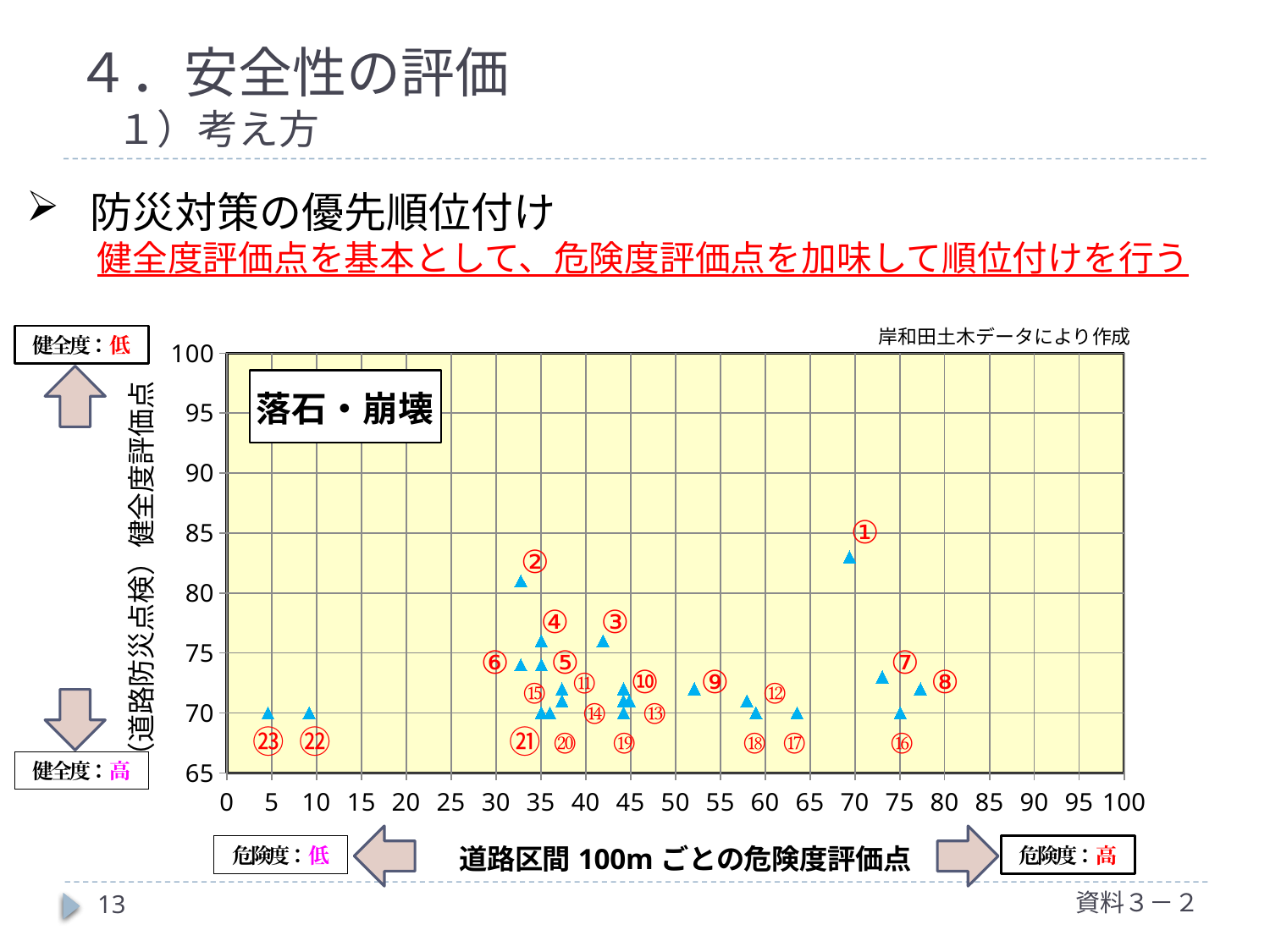
What kind of chart is shown on the slide? scatter chart Which numbered point has the lowest 危険度評価点 (x-axis value)? ㉓ Which numbered point has the highest 健全度評価点 (y-axis value)? ① Is the 危険度評価点 (x value) for point ㉓ greater or less than 10? less Is the 危険度評価点 (x value) for point ① greater or less than 65? greater How many numbered points are plotted on the chart? 23 Which has the larger 健全度評価点 (y value), point ① or point ②? point ① What is the label of the x axis of the chart? 道路区間 100m ごとの危険度評価点 Which has the larger 危険度評価点 (x value), point ③ or point ⑥? point ③ Is the 健全度評価点 (y value) for point ⑧ greater or less than 75? less What is the title shown inside the chart area? 落石・崩壊